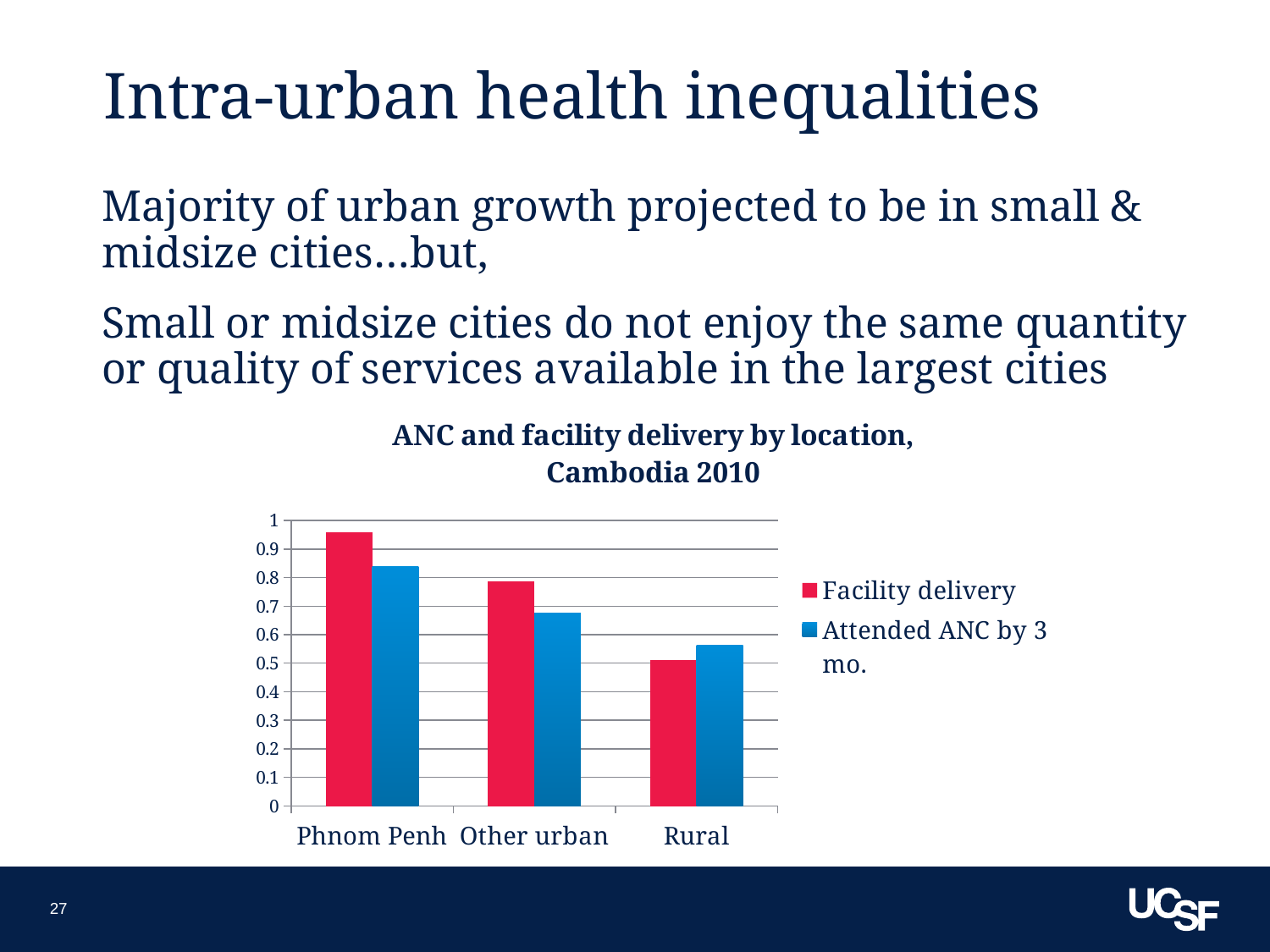
What is the title of the chart? ANC and facility delivery by location, Cambodia 2010 What kind of chart is shown on the slide? bar chart Which location has the lowest Attended ANC by 3 mo. value? Rural For Rural, which is larger: Facility delivery or Attended ANC by 3 mo.? Attended ANC by 3 mo. Which location has the highest Facility delivery value? Phnom Penh How many location categories are shown on the x axis? 3 Is the Facility delivery value for Phnom Penh greater or less than 0.9? greater Is the Attended ANC by 3 mo. value for Other urban greater or less than 0.6? greater Is the Facility delivery value for Rural greater or less than 0.6? less How many series does the legend list? 2 Do the Facility delivery values rise or fall moving from Phnom Penh to Rural along the x axis? fall For Phnom Penh, which is larger: Facility delivery or Attended ANC by 3 mo.? Facility delivery